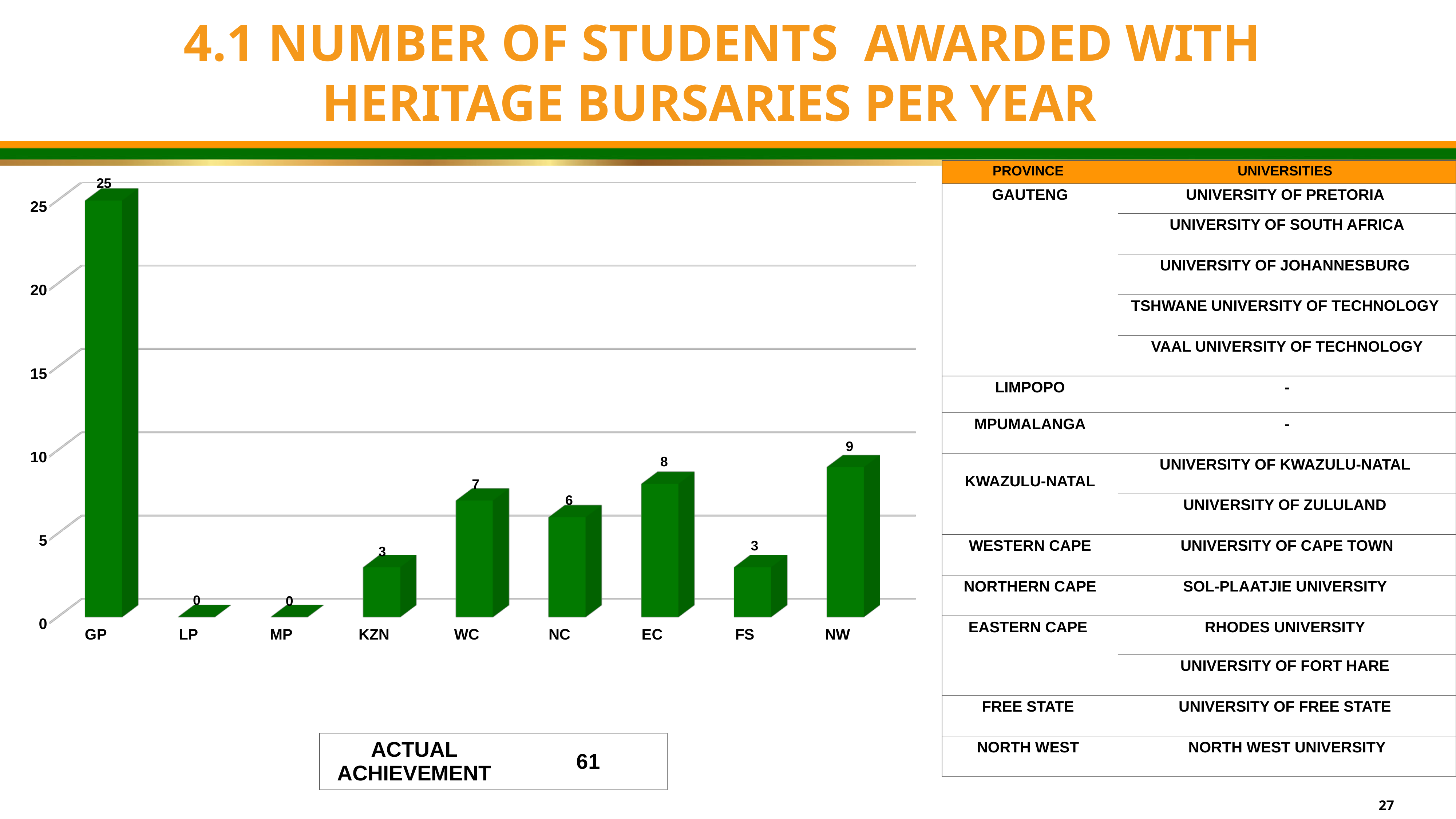
What is the value for EC? 8 What is the value for NW? 9 Which categories have a value of 0? LP and MP What kind of chart is shown on the slide? bar chart What is the value for GP? 25 What is the difference between the values for WC and NC? 1 How many categories are shown on the x axis of the chart? 9 What is the value for KZN? 3 Which is larger, the value for EC or the value for WC? EC Which category has the highest value? GP What colour are the bars in the chart? green What is the difference between the values for GP and NW? 16